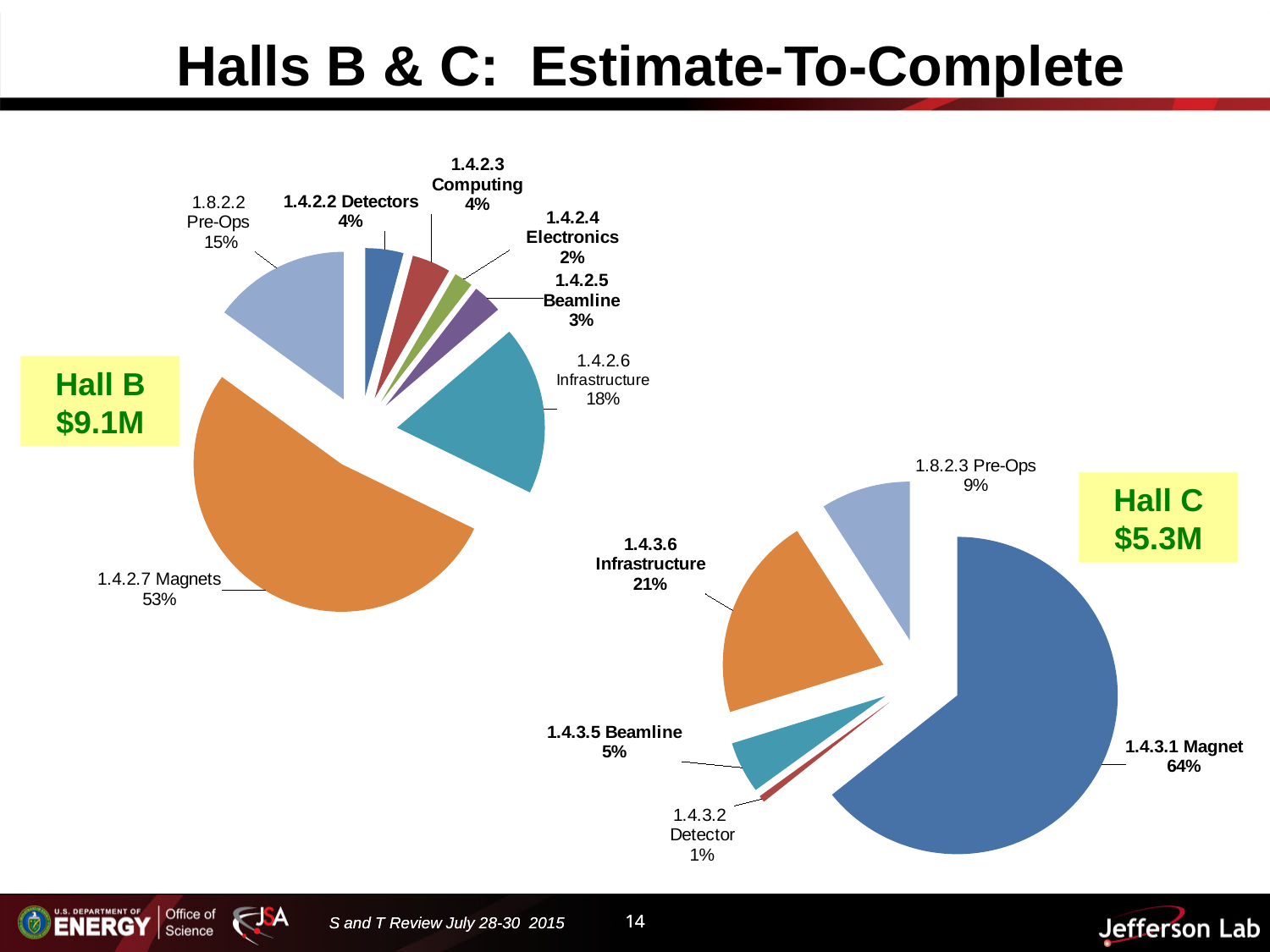
In the Hall C pie chart, what share does 1.4.3.6 Infrastructure have? 21% In the Hall C pie chart, how many slices are there? 5 In the Hall C pie chart, what share does 1.4.3.1 Magnet have? 64% In the Hall B pie chart, which slice is the smallest? 1.4.2.4 Electronics In the Hall B pie chart, how many slices are there? 7 In the Hall C pie chart, which slice is the smallest? 1.4.3.2 Detector In the Hall C pie chart, which is larger: 1.4.3.5 Beamline or 1.8.2.3 Pre-Ops? 1.8.2.3 Pre-Ops In the Hall B pie chart, what share does 1.4.2.7 Magnets have? 53% What type of chart is used for Hall B and Hall C on this slide? Pie chart In the Hall B pie chart, which slice is the largest? 1.4.2.7 Magnets In the Hall B pie chart, what is the difference in percentage points between 1.8.2.2 Pre-Ops and 1.4.2.5 Beamline? 12